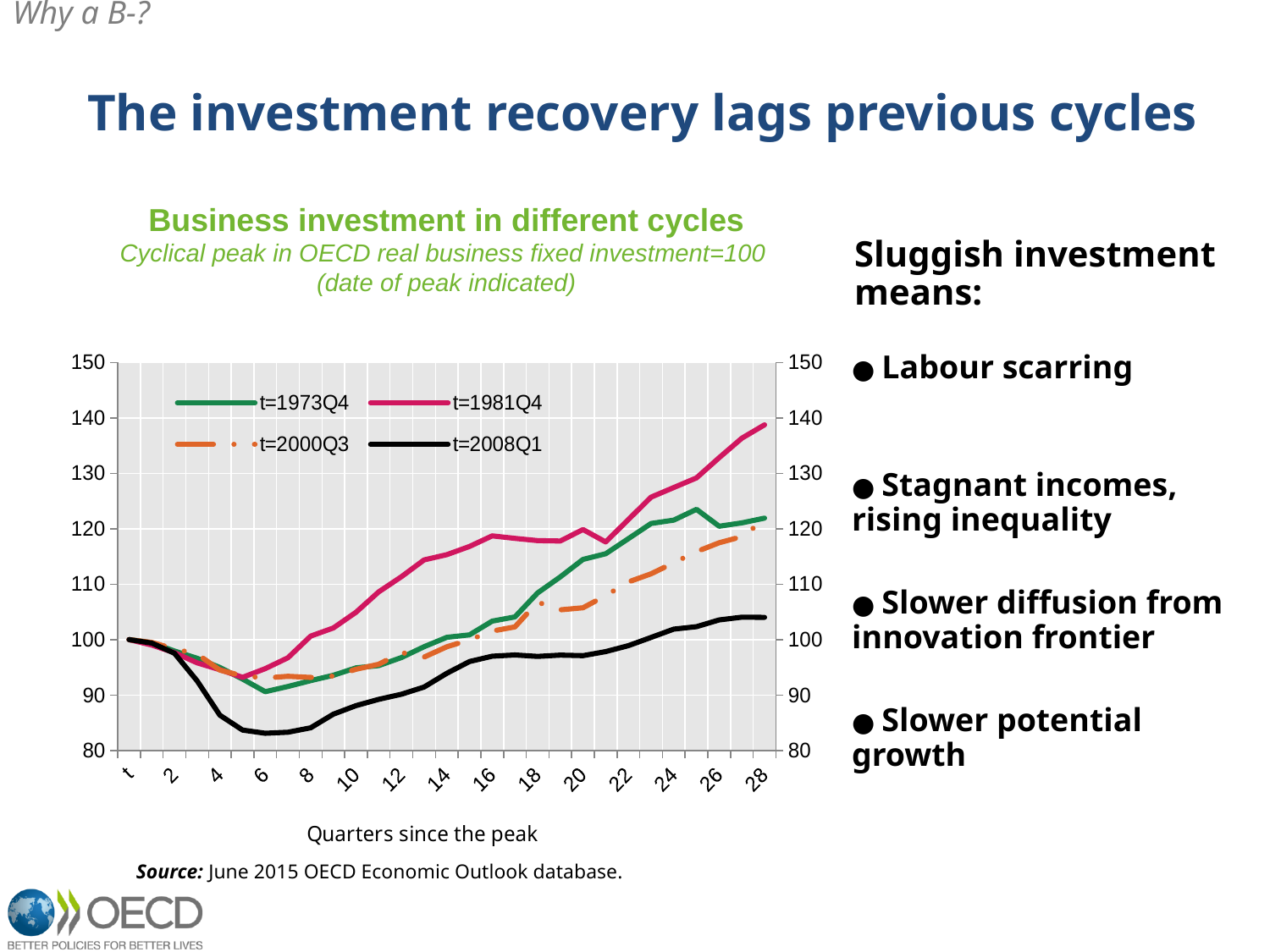
Which series has the lowest value at quarter 28? t=2008Q1 Is the value for t=2008Q1 at quarter 28 greater or less than 110? less What is the label of the x axis of the chart? Quarters since the peak What is the title of the chart? Business investment in different cycles Which series has the highest value at quarter 28? t=1981Q4 What kind of chart is shown on the slide? line chart Is the value for t=1981Q4 at quarter 28 greater or less than 130? greater At quarter 6, which series has the larger value, t=1973Q4 or t=2008Q1? t=1973Q4 What is the value of the t=1981Q4 series at quarter t (the peak)? 100 How many series does the chart legend list? 4 What is the value of the t=2008Q1 series at quarter t (the peak)? 100 Does the t=1981Q4 series rise or fall between quarter 10 and quarter 28? rise